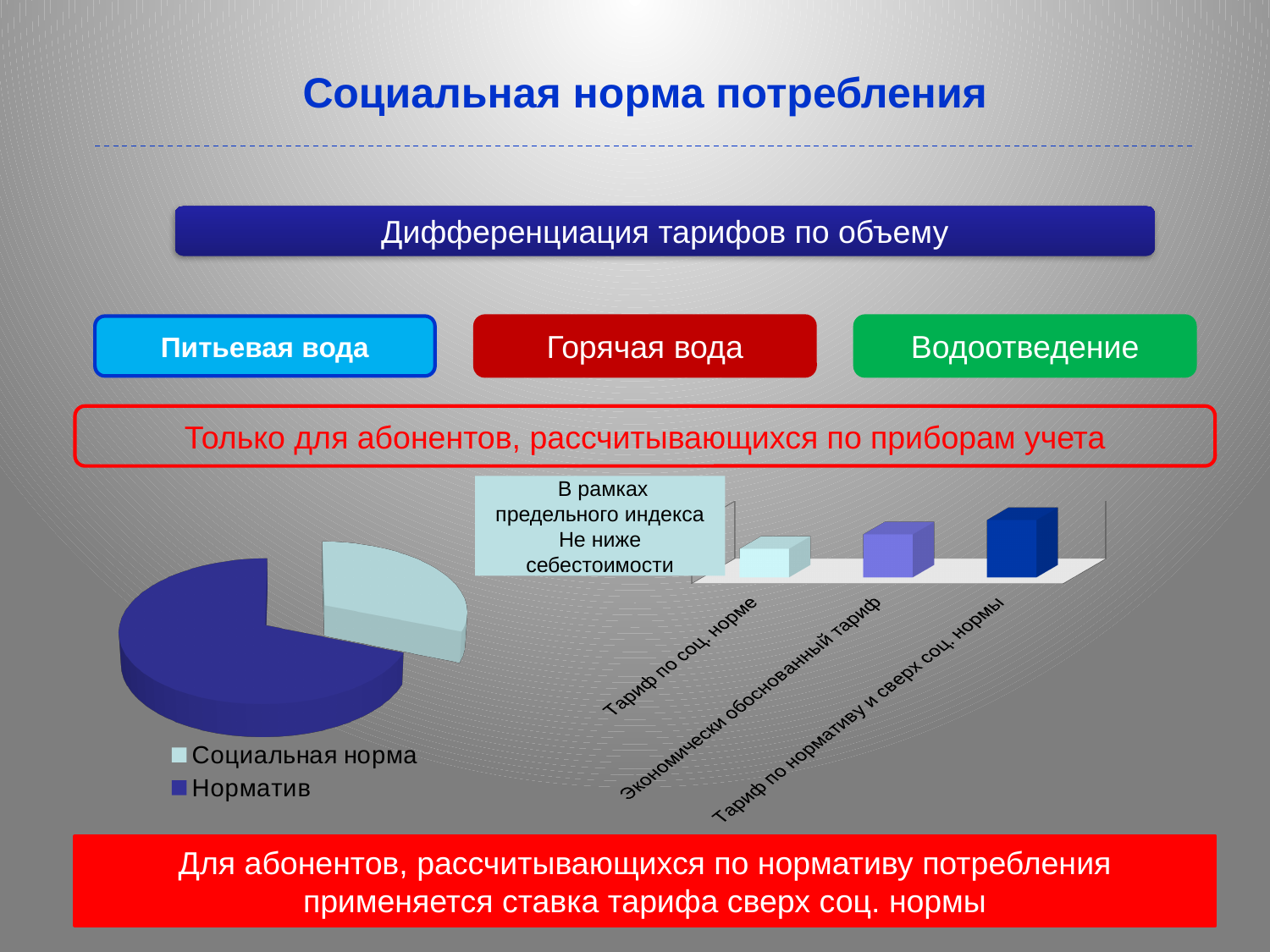
In the bar chart on the right, do the bars rise or fall from left to right? rise In the pie chart on the left, what colour is the Норматив slice? dark blue In the bar chart on the right, which bar is taller, Тариф по соц. норме or Экономически обоснованный тариф? Экономически обоснованный тариф In the bar chart on the right, how many categories are shown? 3 In the pie chart on the left, how many entries does the legend list? 2 In the bar chart on the right, which category has the highest bar? Тариф по нормативу и сверх соц. нормы In the pie chart on the left, which slice is the smallest? Социальная норма In the pie chart on the left, which slice is larger, Социальная норма or Норматив? Норматив In the pie chart on the left, what colour is the Социальная норма slice? light blue In the bar chart on the right, which category has the lowest bar? Тариф по соц. норме What kind of chart is the chart on the right of the slide? bar chart What kind of chart is the chart on the left of the slide? pie chart